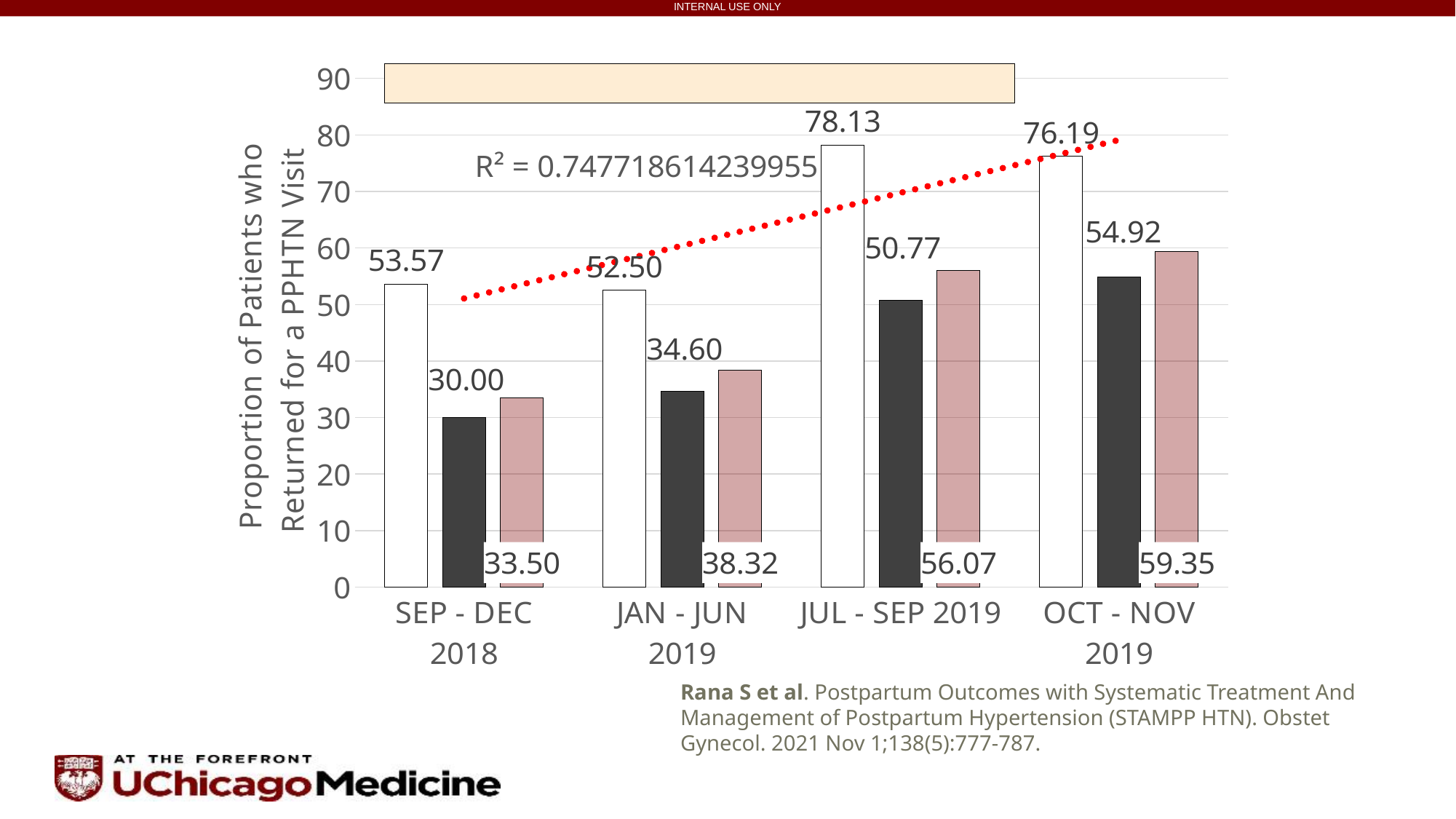
Which period has the lowest value for the dark grey bars? SEP - DEC 2018 What is the value of the pink bar for JAN - JUN 2019? 38.32 Is the value of the white bar for OCT - NOV 2019 greater or less than 70? greater Which is larger for OCT - NOV 2019: the dark grey bar or the pink bar? the pink bar What is the value of the white bar for JUL - SEP 2019? 78.13 How many time periods are shown on the x axis? 4 What is the value of the pink bar for OCT - NOV 2019? 59.35 Which period has the highest value for the white bars? JUL - SEP 2019 What kind of chart is shown on the slide? bar chart What is the y-axis title of the chart? Proportion of Patients who Returned for a PPHTN Visit What is the difference between the white bar values for JUL - SEP 2019 and SEP - DEC 2018? 24.56 What is the value of the dark grey bar for SEP - DEC 2018? 30.00